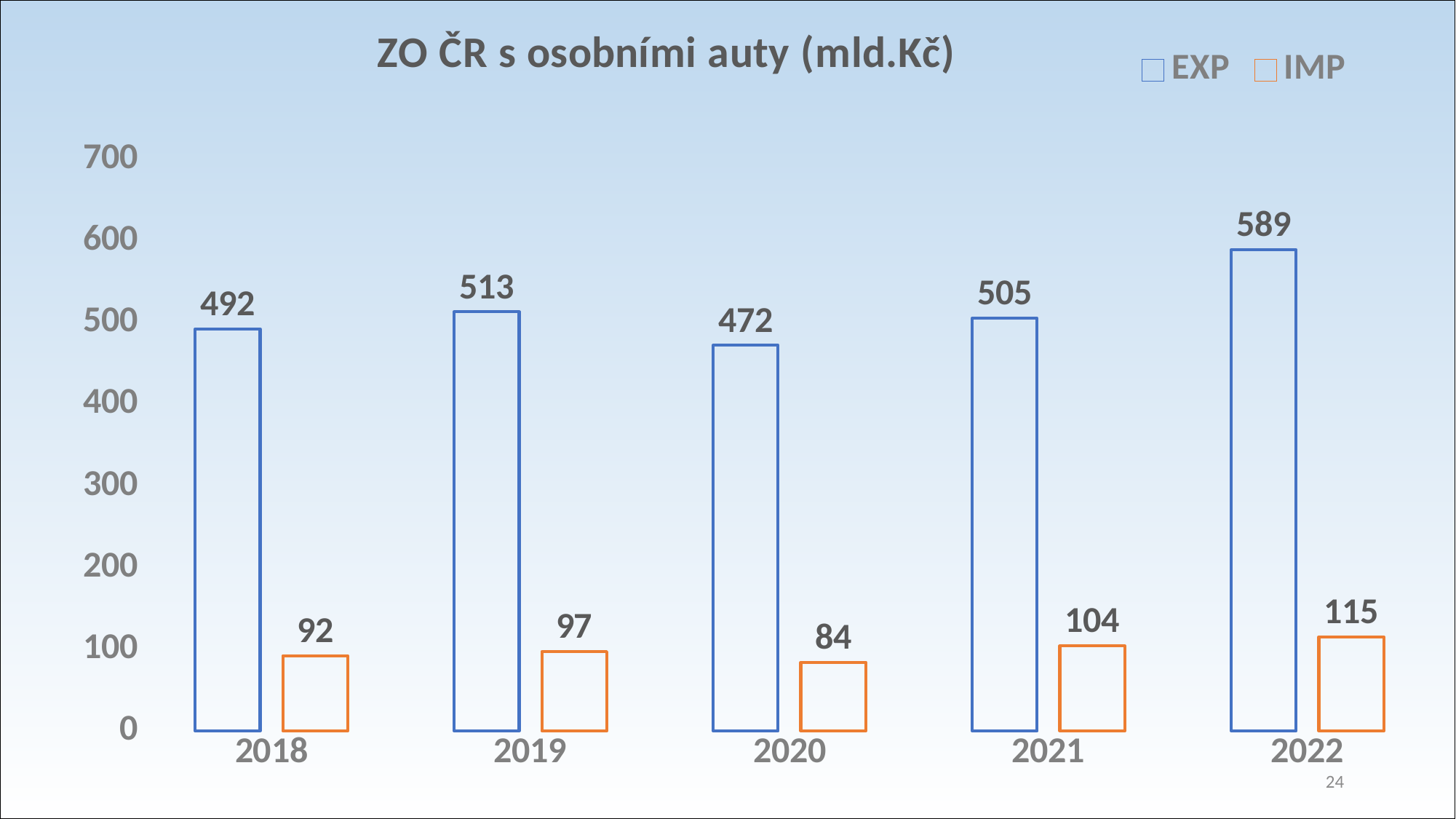
How many years are shown on the x axis? 5 Which year has the lowest IMP value? 2020 What is the IMP value for 2021? 104 How many series does the legend list? 2 Is the EXP value for 2021 greater or less than 400? greater What kind of chart is shown on the slide? bar chart What is the title of the chart? ZO ČR s osobními auty (mld.Kč) What is the difference between the EXP value and the IMP value in 2022? 474 What is the difference between the EXP values for 2019 and 2018? 21 Which year has the highest EXP value? 2022 Which is larger, the IMP value for 2019 or the IMP value for 2018? 2019 What is the EXP value for 2020? 472